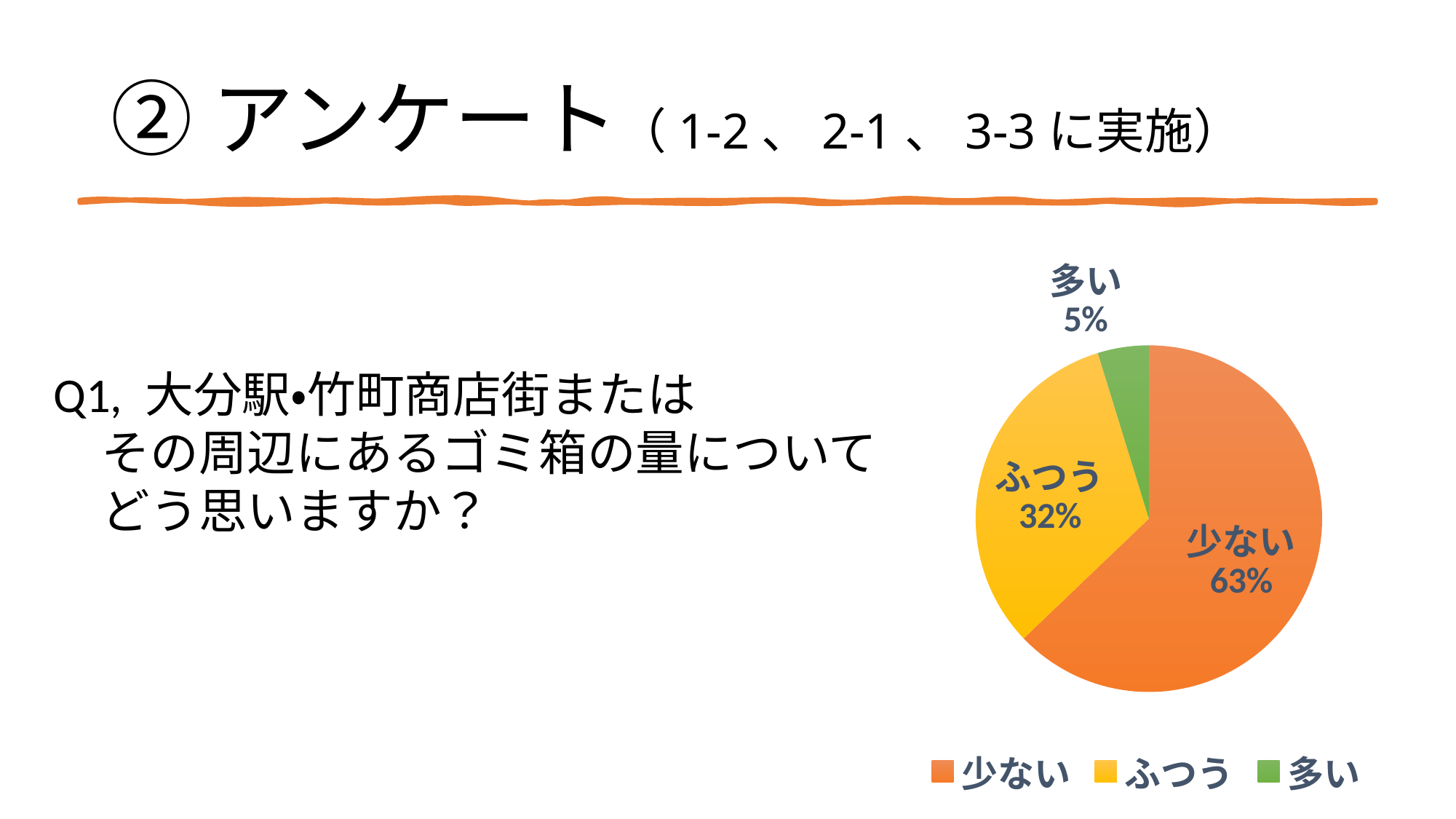
Which is larger, the share for ふつう or the share for 多い? ふつう Which response has the smallest share of the pie? 多い What colour is the slice for 多い? Green What percentage of respondents answered 多い? 5% What is the difference in percentage points between 少ない and ふつう? 31 Which response has the largest share of the pie? 少ない What percentage of respondents answered ふつう? 32% How many entries does the legend list? 3 How many slices does the pie chart have? 3 What kind of chart is shown on the slide? Pie chart What percentage of respondents answered 少ない? 63% What is the difference in percentage points between ふつう and 多い? 27